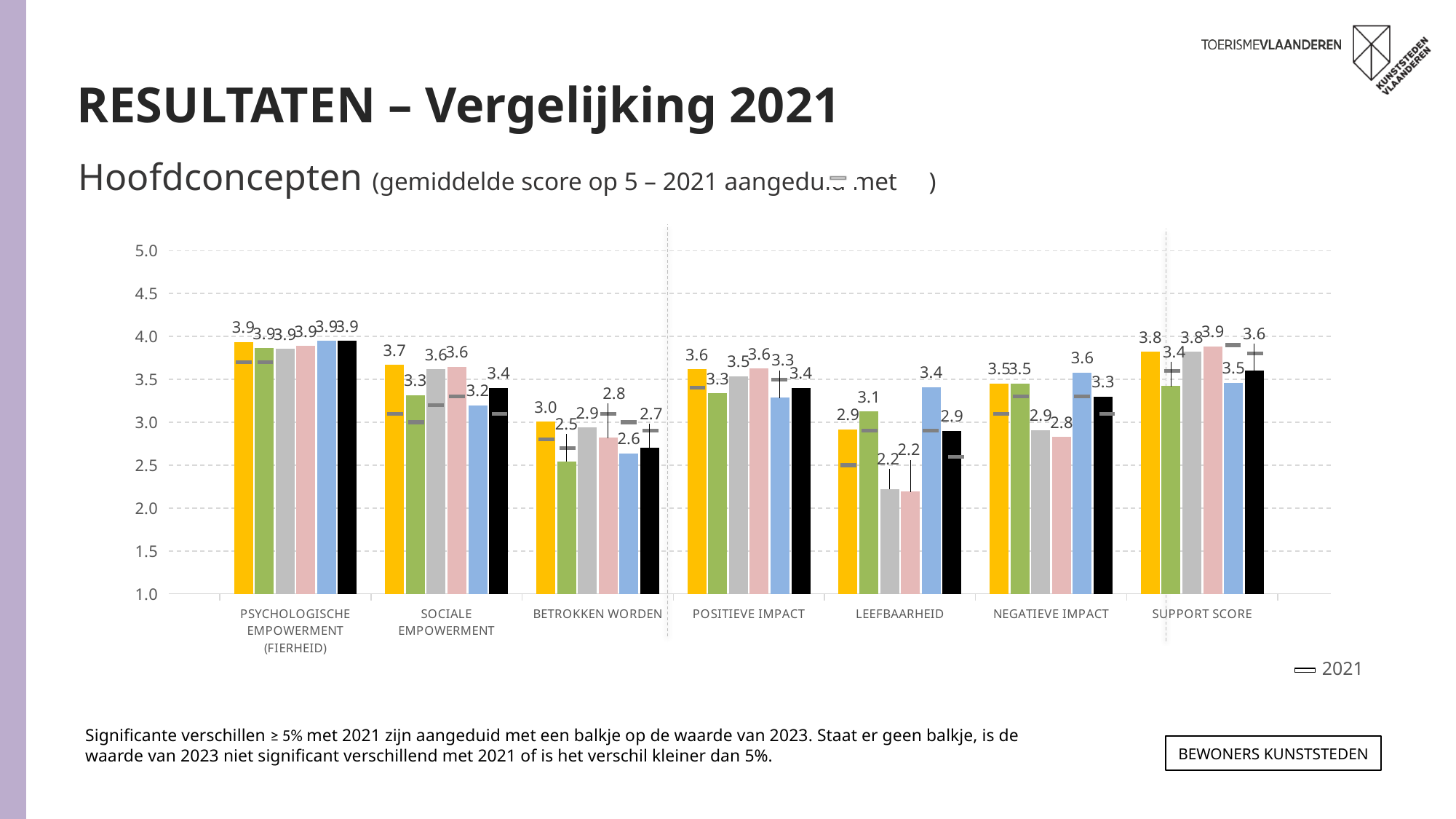
What is the value of the pink bar for Support Score? 3.9 What year does the legend marker below the chart refer to? 2021 What is the difference between the blue bar (3.4) and the grey bar (2.2) for Leefbaarheid? 1.2 What is the value of the black bar for Sociale Empowerment? 3.4 How many categories are shown along the x axis of the chart? 7 What is the maximum value shown on the y axis of the chart? 5.0 What is the highest value shown for Leefbaarheid? 3.4 Is the value of the grey bar for Leefbaarheid greater or less than 2.5? less What kind of chart is shown on the slide? bar chart What is the lowest value shown for Betrokken Worden? 2.5 What is the value of the yellow bar for Betrokken Worden? 3.0 For Negatieve Impact, which is larger: the blue bar or the pink bar? the blue bar